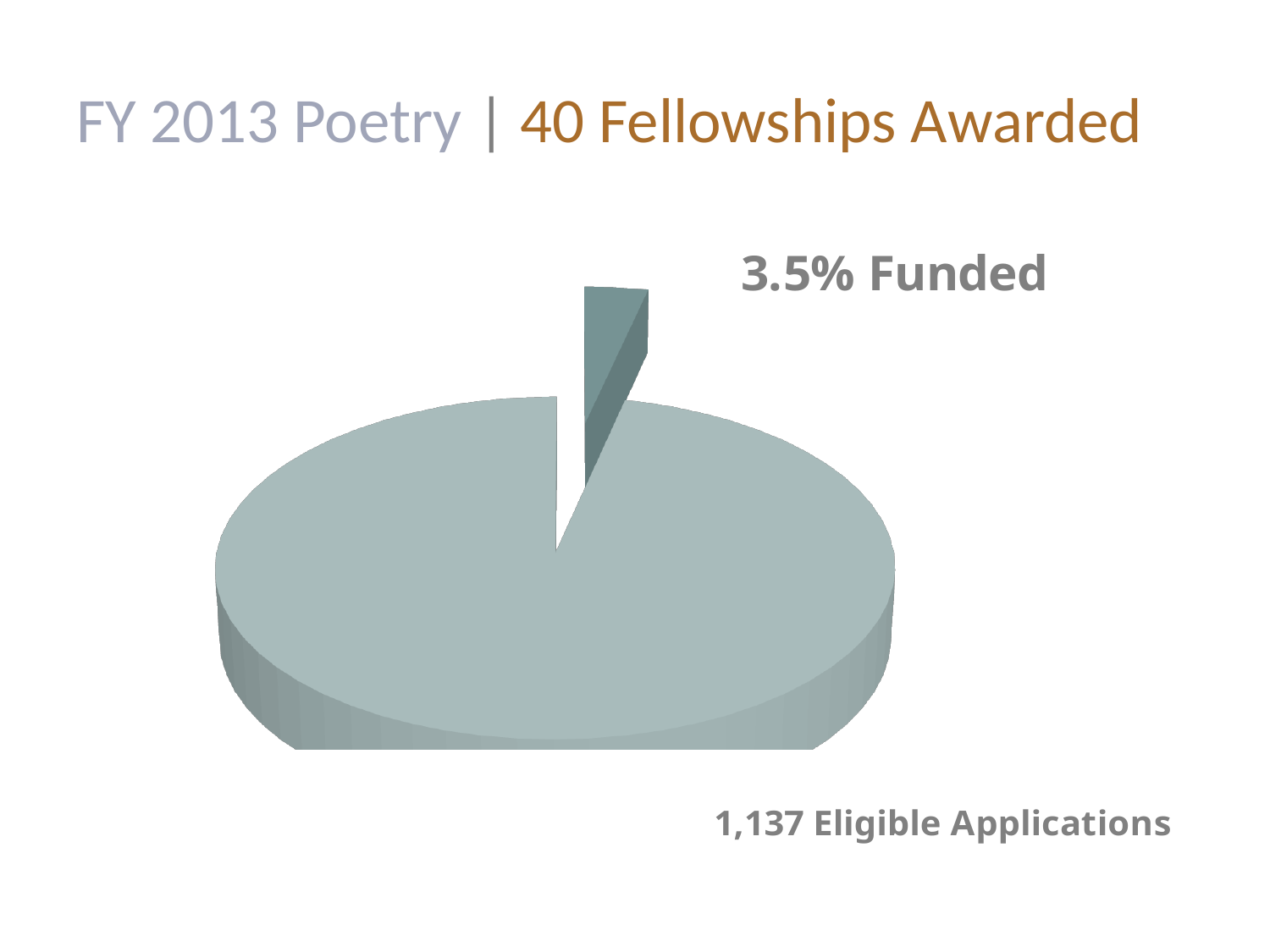
Which slice is larger, the funded slice or the unlabelled remaining slice? The unlabelled remaining slice How many fellowships were awarded according to the slide title? 40 What share of the pie is labelled as funded? 3.5% How many eligible applications does the slide report? 1,137 What is the title of the slide containing the pie chart? FY 2013 Poetry | 40 Fellowships Awarded What label is attached to the small exploded slice of the pie? 3.5% Funded Is the funded share of the pie greater or less than 10%? less What kind of chart is shown on the slide? Pie chart How many slices does the pie chart have? 2